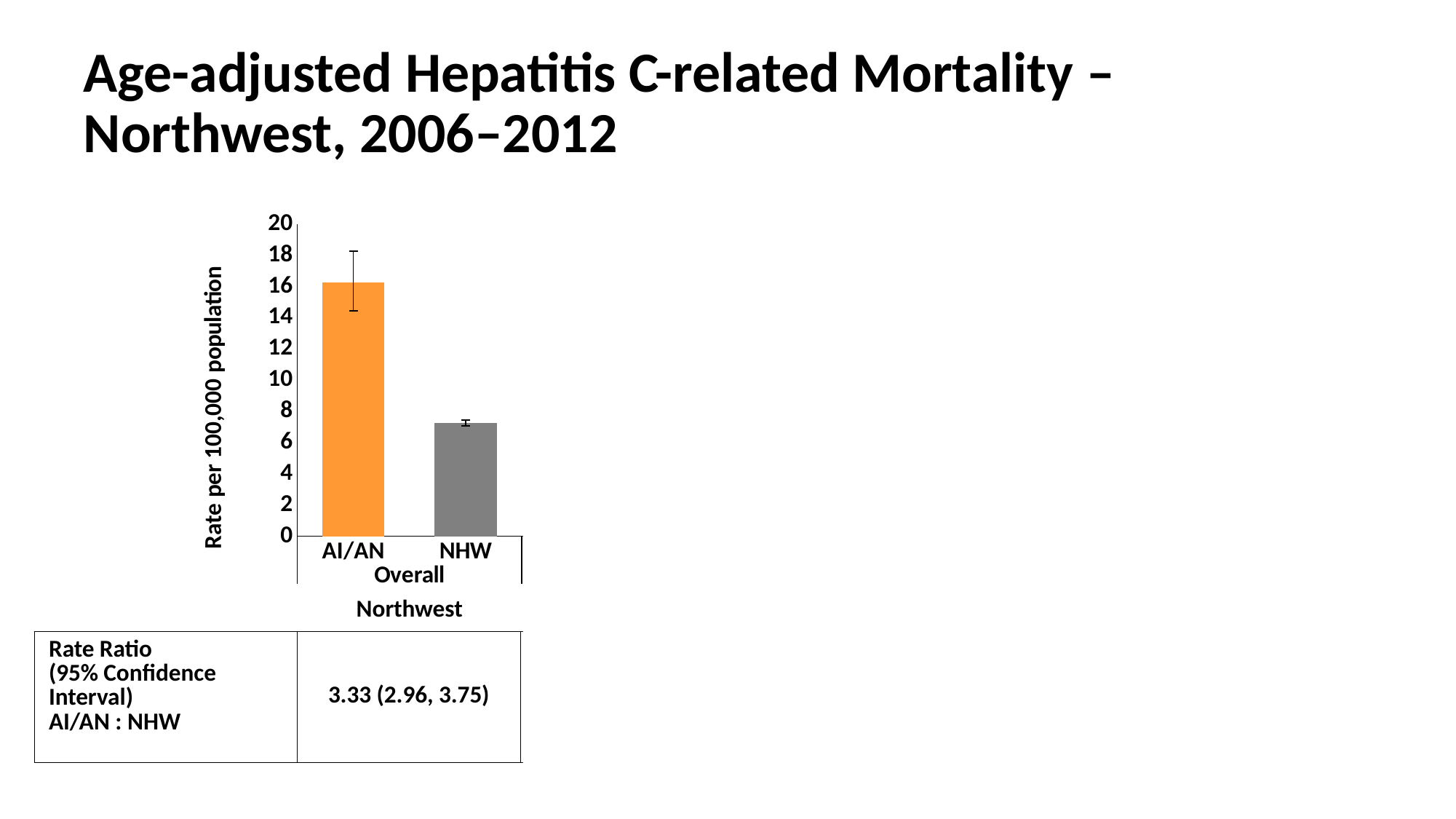
Is the value for NHW greater or less than 8? less What colour is the AI/AN bar in the chart? orange Is the value for NHW greater or less than 6? greater What is the label on the vertical axis of the chart? Rate per 100,000 population How many bars are plotted in the chart? 2 Is the value for AI/AN greater or less than 18? less What kind of chart is shown on the slide? bar chart Which group has the highest age-adjusted Hepatitis C-related mortality rate in the chart? AI/AN Which group has the lowest age-adjusted Hepatitis C-related mortality rate in the chart? NHW Which bar is taller, AI/AN or NHW? AI/AN